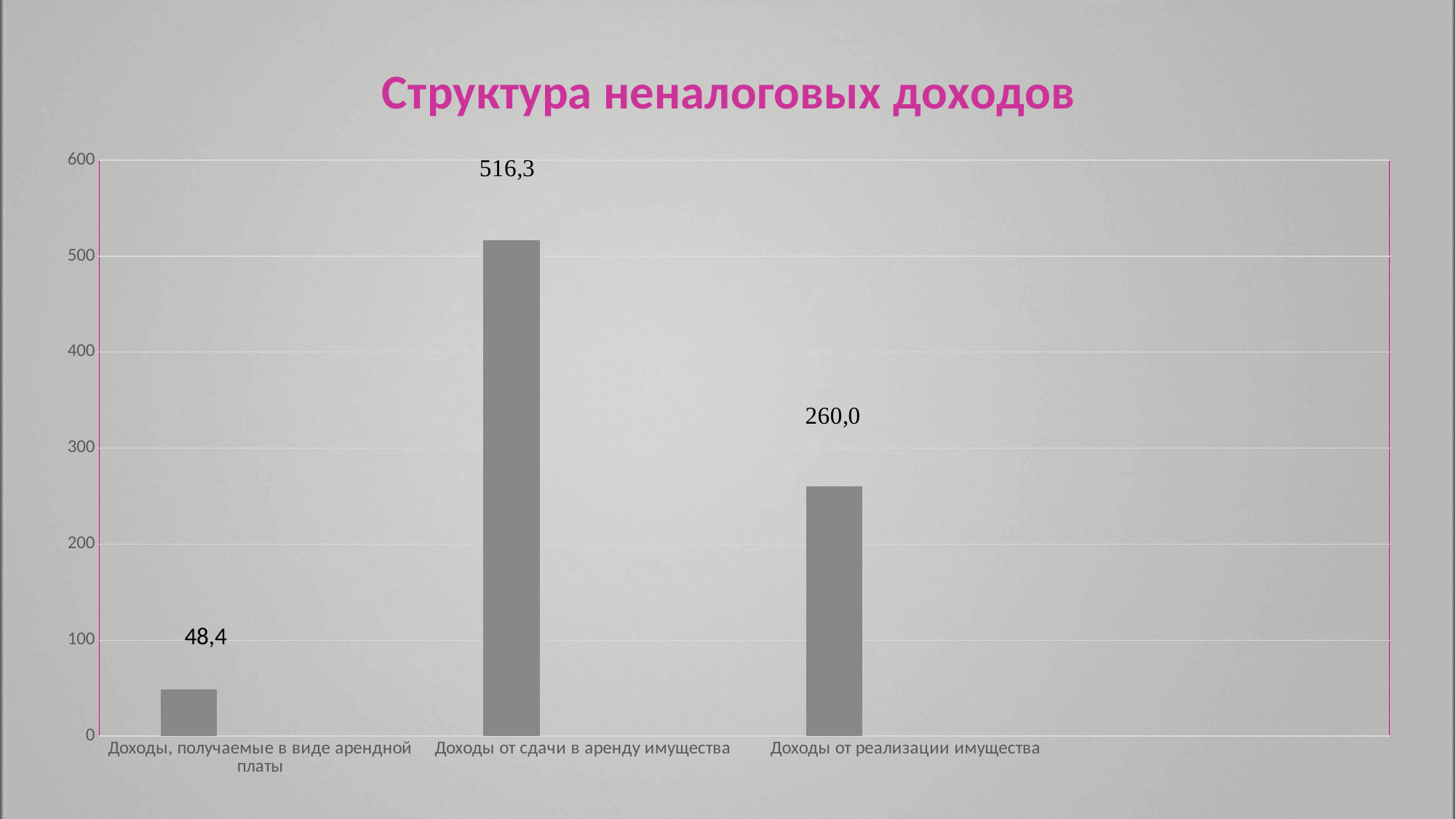
Which category has the lowest value? Доходы, получаемые в виде арендной платы What is the value for "Доходы от реализации имущества"? 260,0 Which is larger: the value for "Доходы от реализации имущества" or the value for "Доходы, получаемые в виде арендной платы"? Доходы от реализации имущества Is the value for "Доходы от сдачи в аренду имущества" greater or less than 500? greater What is the value for "Доходы от сдачи в аренду имущества"? 516,3 What is the difference between the values for "Доходы от сдачи в аренду имущества" and "Доходы от реализации имущества"? 256,3 What is the title of the chart? Структура неналоговых доходов What is the difference between the values for "Доходы от реализации имущества" and "Доходы, получаемые в виде арендной платы"? 211,6 How many categories are shown in the chart? 3 Which category has the highest value? Доходы от сдачи в аренду имущества What is the value for "Доходы, получаемые в виде арендной платы"? 48,4 What kind of chart is shown on the slide? bar chart